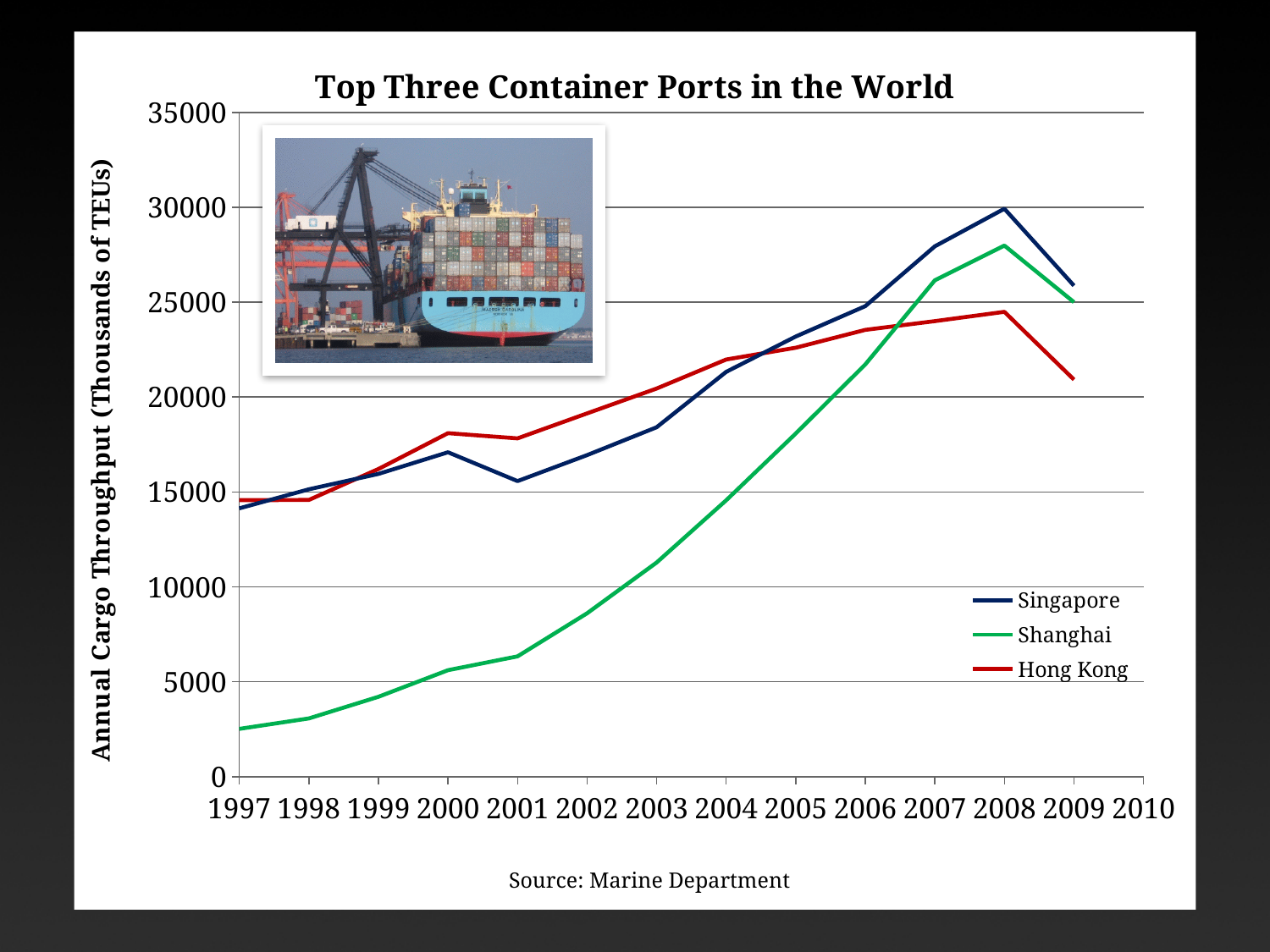
Is the value for Hong Kong in 2000 greater or less than 20000? less Which port had the highest throughput in 2008? Singapore In which year does the Singapore line reach its peak? 2008 Which port had the lowest throughput in 1997? Shanghai Is the value for Shanghai in 1997 greater or less than 5000? less What is the title of the chart? Top Three Container Ports in the World How many series does the legend list? 3 In 2009, which is larger, the value for Shanghai or the value for Hong Kong? Shanghai Is the value for Singapore in 2008 greater or less than 25000? greater What kind of chart is shown on the slide? line chart Which port is represented by the green line? Shanghai Does the Shanghai line rise or fall from 1997 to 2008? rise